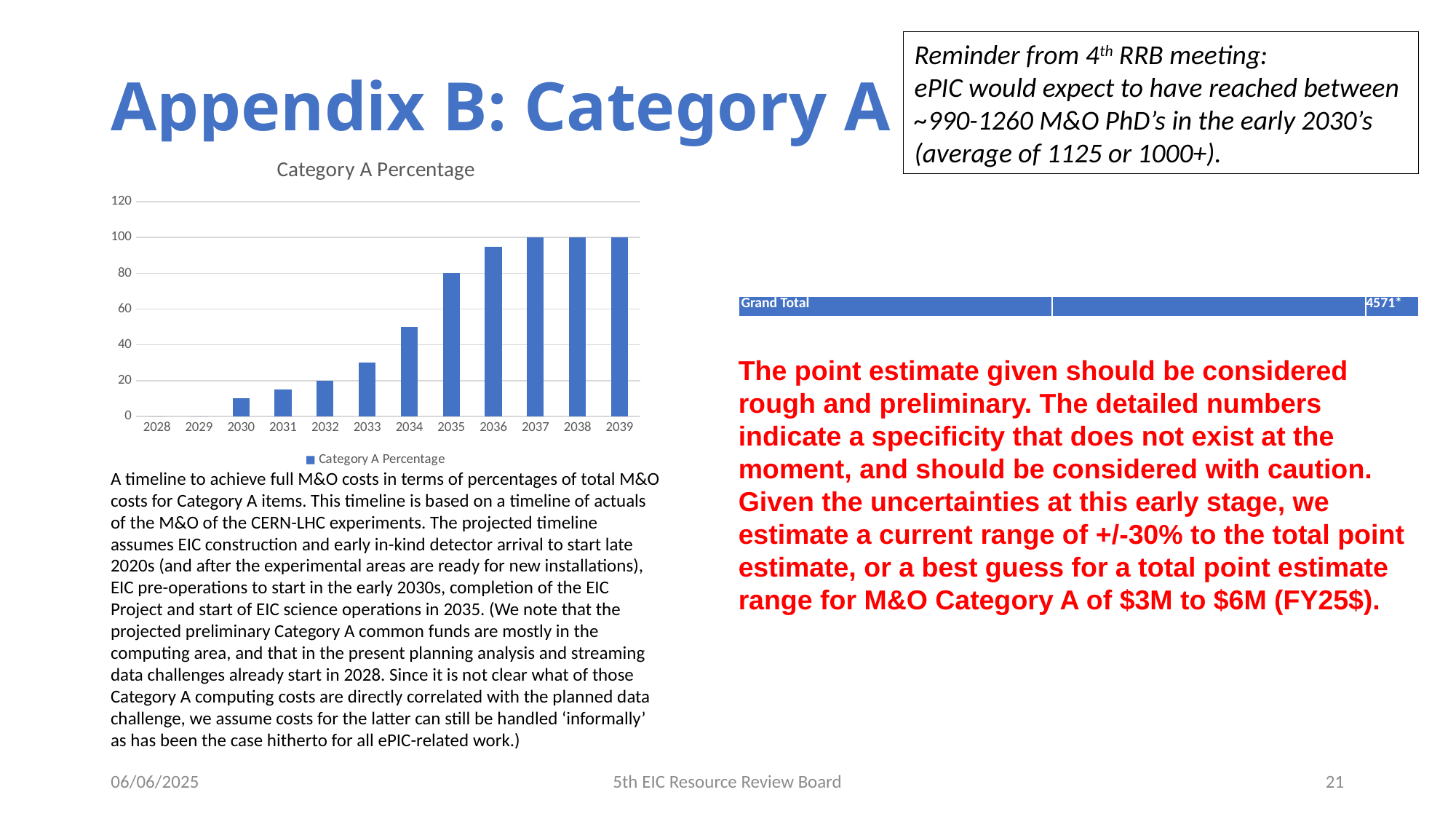
Is the value for 2031 greater or less than 20? less Do the values rise or fall from 2028 to 2039? rise Is the value for 2034 greater or less than 40? greater How many years are shown on the x axis of the chart? 12 What is the Category A Percentage value for 2035? 80 How many series does the chart legend list? 1 What type of chart is shown on the slide? bar chart What is the difference between the values for 2037 and 2035? 20 What is the Category A Percentage value for 2037? 100 Which is larger, the value for 2033 or the value for 2035? 2035 What is the title of the chart? Category A Percentage What is the Category A Percentage value for 2032? 20